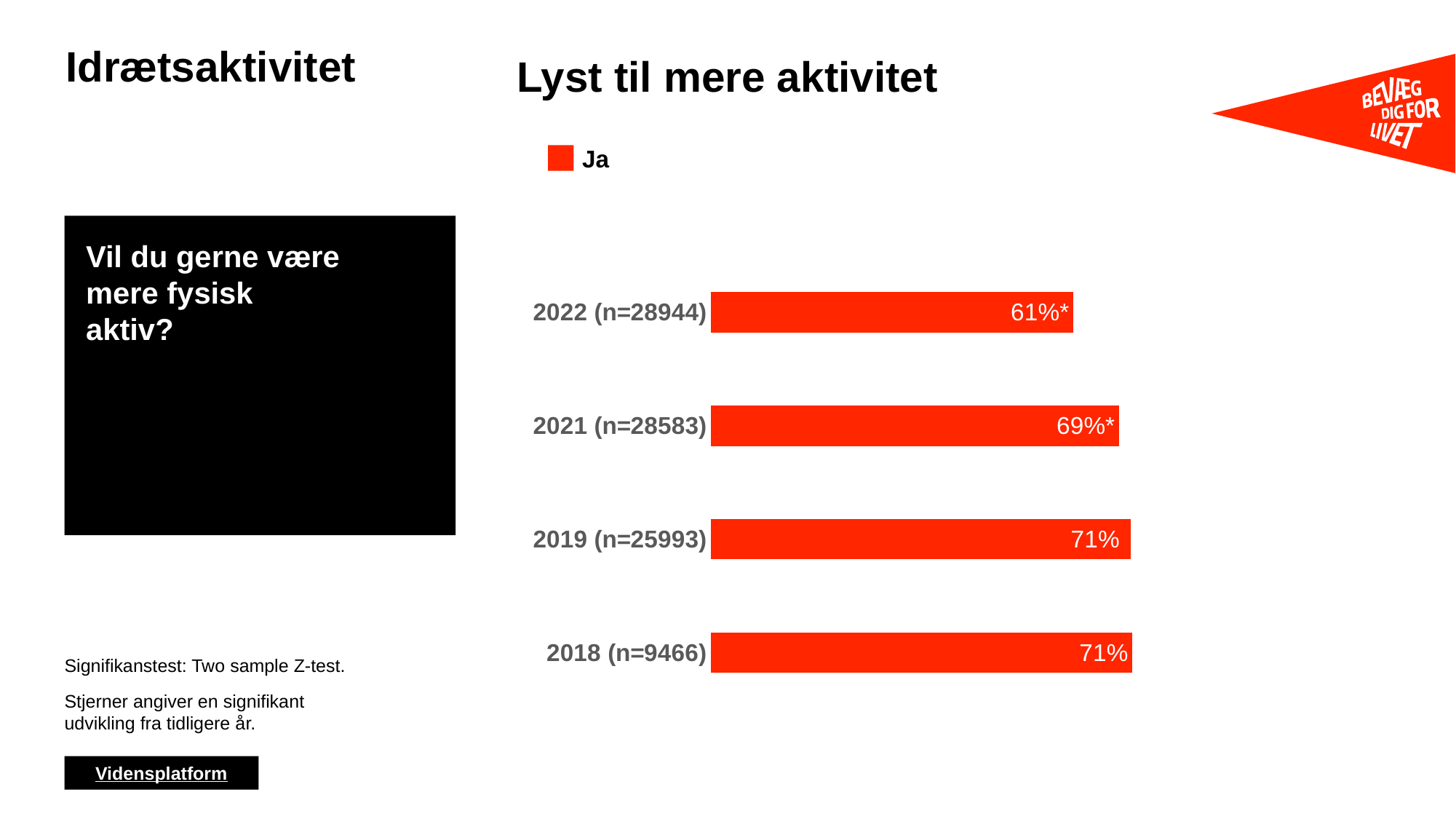
How many series does the legend list? 1 What is the value for 2019 (n=25993)? 71% Which year has the lowest value? 2022 (n=28944) What is the difference between the values for 2019 and 2021? 2% What kind of chart is shown? bar chart What is the title of the chart? Lyst til mere aktivitet How many bars are shown in the chart? 4 Which is larger, the value for 2021 or the value for 2022? 2021 What is the difference between the values for 2021 and 2022? 8% What is the value for 2018 (n=9466)? 71% What is the value for 2022 (n=28944)? 61%* What is the value for 2021 (n=28583)? 69%*